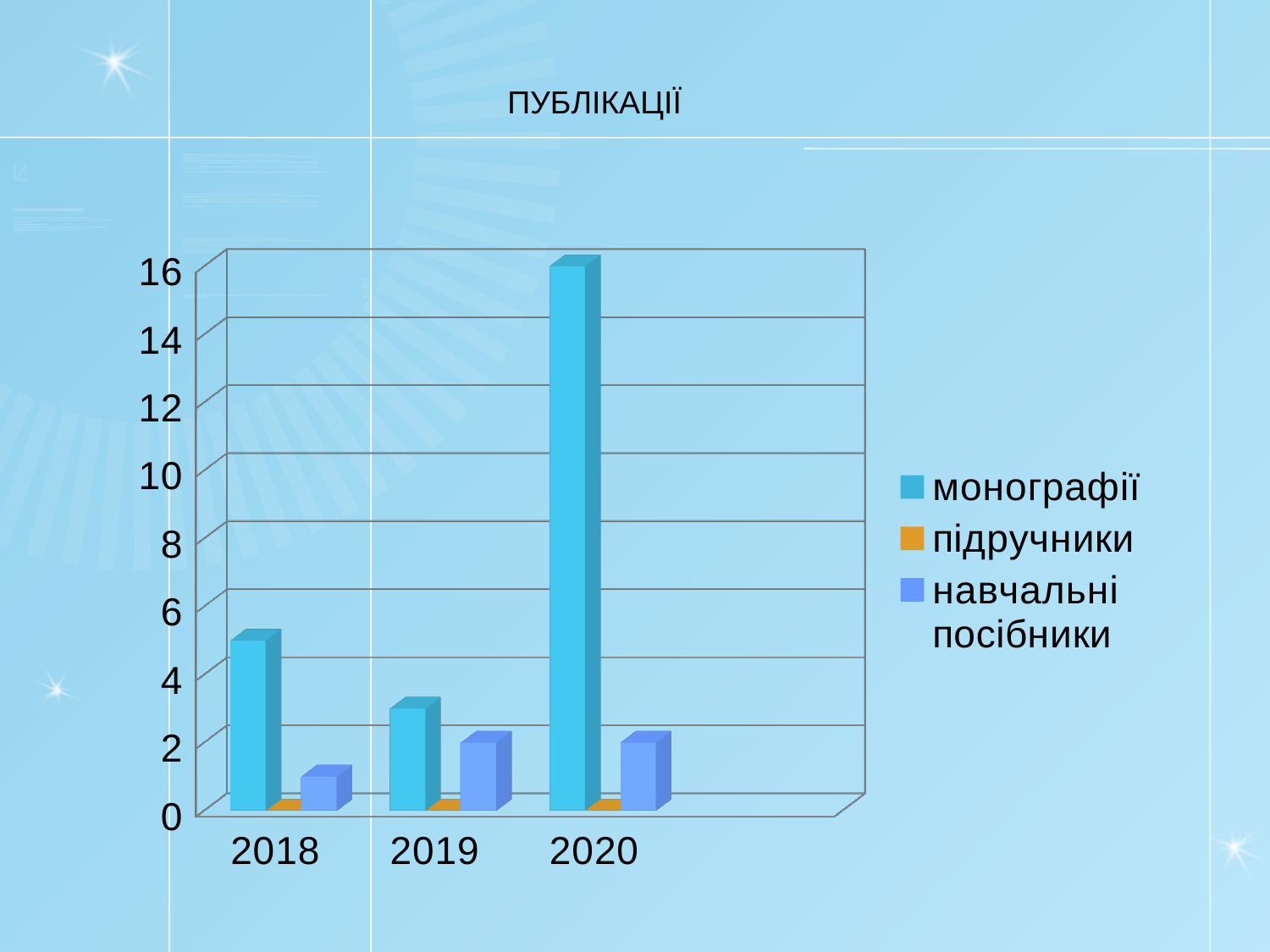
Which is larger in 2018: монографії or навчальні посібники? монографії How many series does the legend list? 3 How many years are shown on the x axis? 3 Is the value for монографії in 2018 greater or less than 4? greater In which year is the value for монографії highest? 2020 Which legend entry is shown in orange? підручники What is the title of the chart? ПУБЛІКАЦІЇ What kind of chart is shown on the slide? bar chart Which series has the smallest bars in every year? підручники In which year is the value for монографії lowest? 2019 Is the value for монографії in 2019 greater or less than 4? less Is the value for монографії in 2020 greater or less than 14? greater